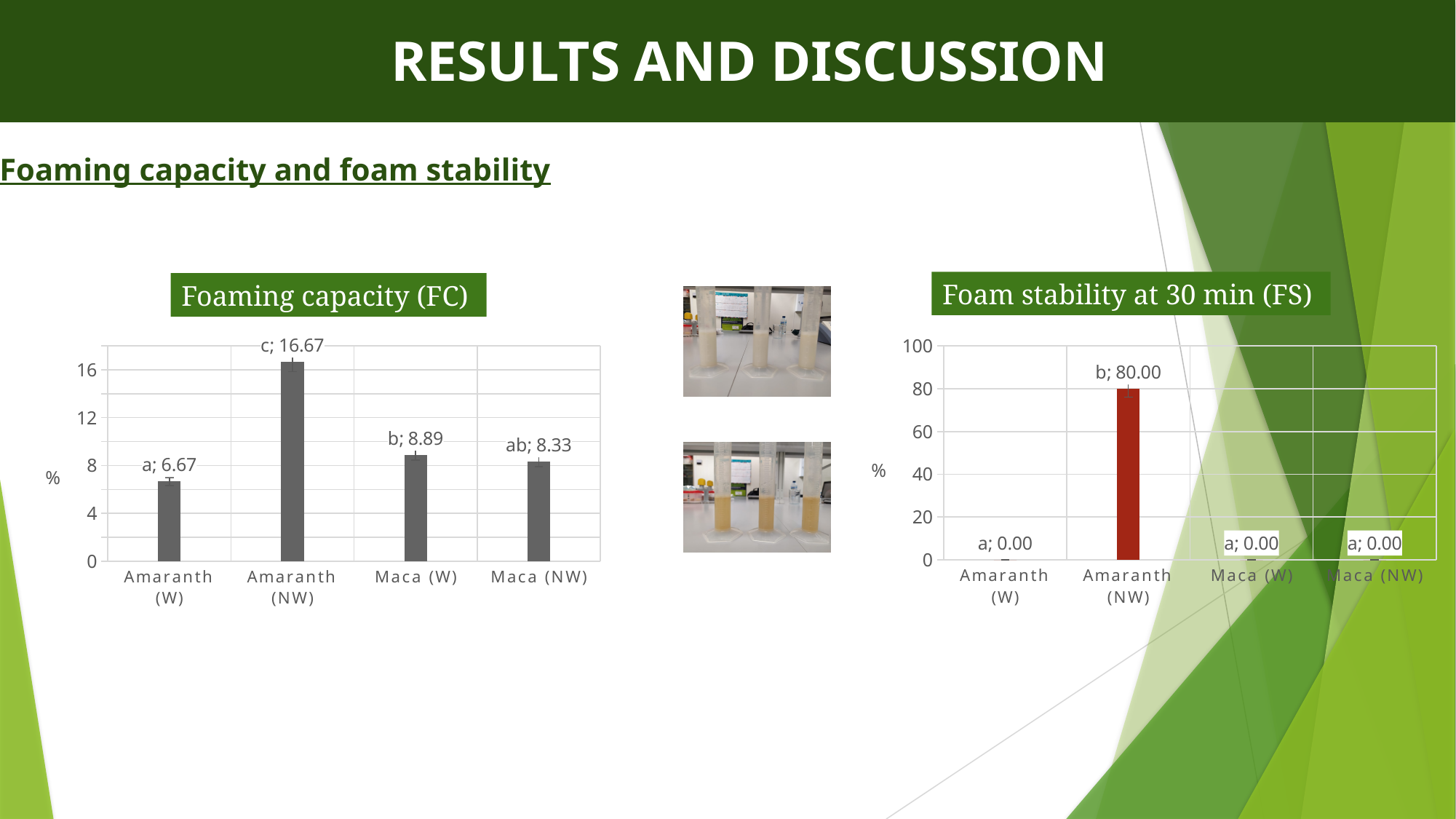
In the Foaming capacity (FC) chart, which category has the lowest value? Amaranth (W) In the Foaming capacity (FC) chart, what is the difference between the values for Amaranth (NW) and Amaranth (W)? 10.00 In the Foaming capacity (FC) chart, what is the value for Amaranth (NW)? 16.67 In the Foaming capacity (FC) chart, what is the value for Maca (W)? 8.89 In the Foaming capacity (FC) chart, which is larger, the value for Maca (W) or Maca (NW)? Maca (W) In the Foaming capacity (FC) chart, how many categories are shown on the x axis? 4 In the Foam stability at 30 min (FS) chart, which category has the highest value? Amaranth (NW) In the Foam stability at 30 min (FS) chart, what is the value for Maca (W)? 0.00 In the Foaming capacity (FC) chart, which category has the highest value? Amaranth (NW) In the Foam stability at 30 min (FS) chart, what is the value for Amaranth (NW)? 80.00 What kind of chart is the Foam stability at 30 min (FS) chart? Bar chart In the Foam stability at 30 min (FS) chart, what colour is the bar for Amaranth (NW)? Red